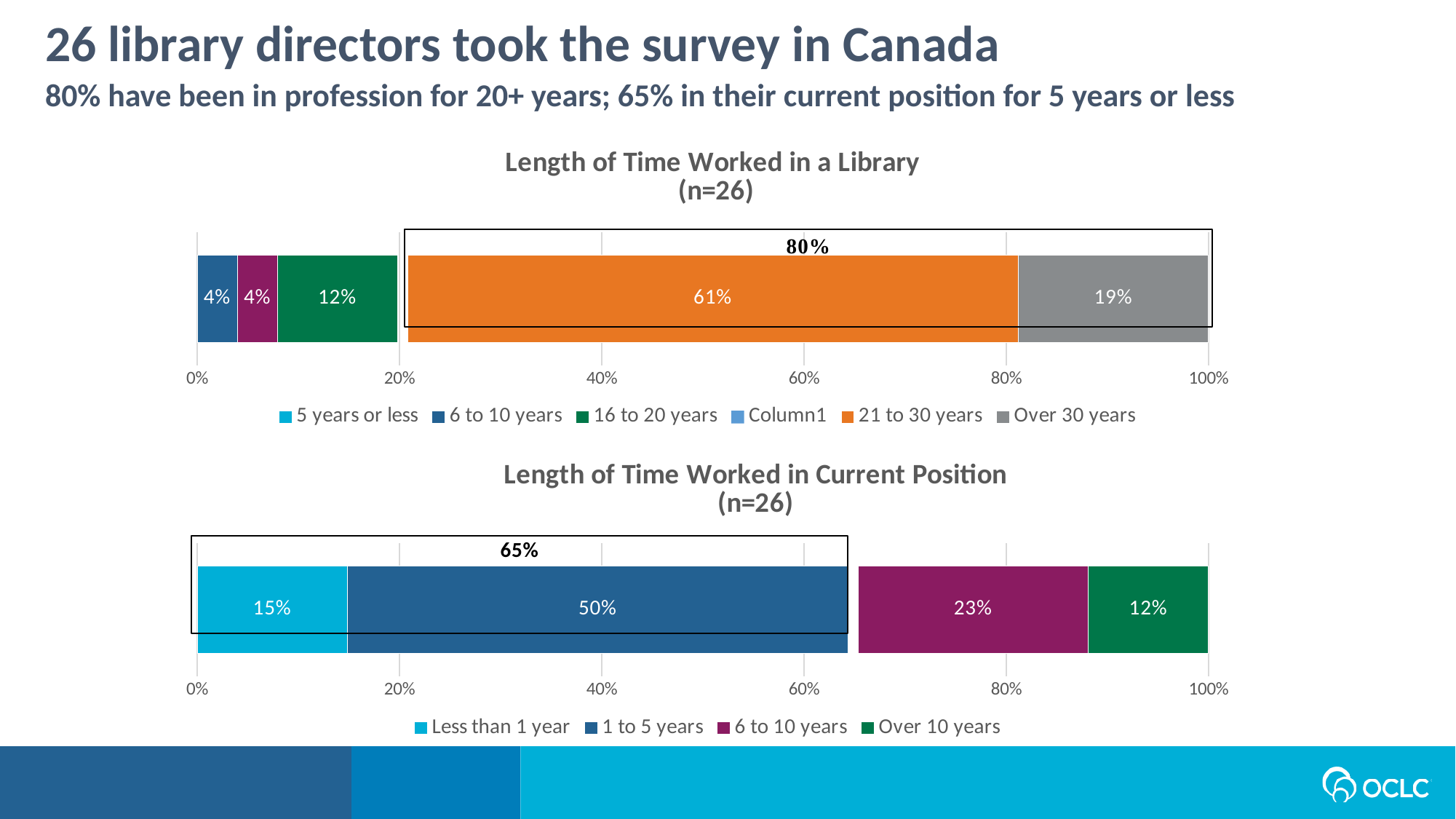
In the 'Length of Time Worked in Current Position' chart, which category has the smallest share? Over 10 years In the 'Length of Time Worked in Current Position' chart, what is the difference between the 1 to 5 years share and the less than 1 year share? 35% In the 'Length of Time Worked in a Library' chart, what is the combined percentage highlighted for 21 to 30 years and over 30 years? 80% In the 'Length of Time Worked in a Library' chart, what percentage of directors have worked over 30 years? 19% What type of chart is used for 'Length of Time Worked in Current Position'? Stacked bar chart In the 'Length of Time Worked in a Library' chart, what percentage of directors have worked 16 to 20 years? 12% In the 'Length of Time Worked in a Library' chart, how many entries does the legend list? 6 In the 'Length of Time Worked in Current Position' chart, what percentage of directors have been in their position 1 to 5 years? 50% In the 'Length of Time Worked in Current Position' chart, what percentage of directors have been in their position 6 to 10 years? 23% In the 'Length of Time Worked in a Library' chart, which category has the largest share? 21 to 30 years In the 'Length of Time Worked in a Library' chart, what percentage of directors have worked 21 to 30 years? 61% In the 'Length of Time Worked in Current Position' chart, which is larger: the share for 6 to 10 years or the share for over 10 years? 6 to 10 years